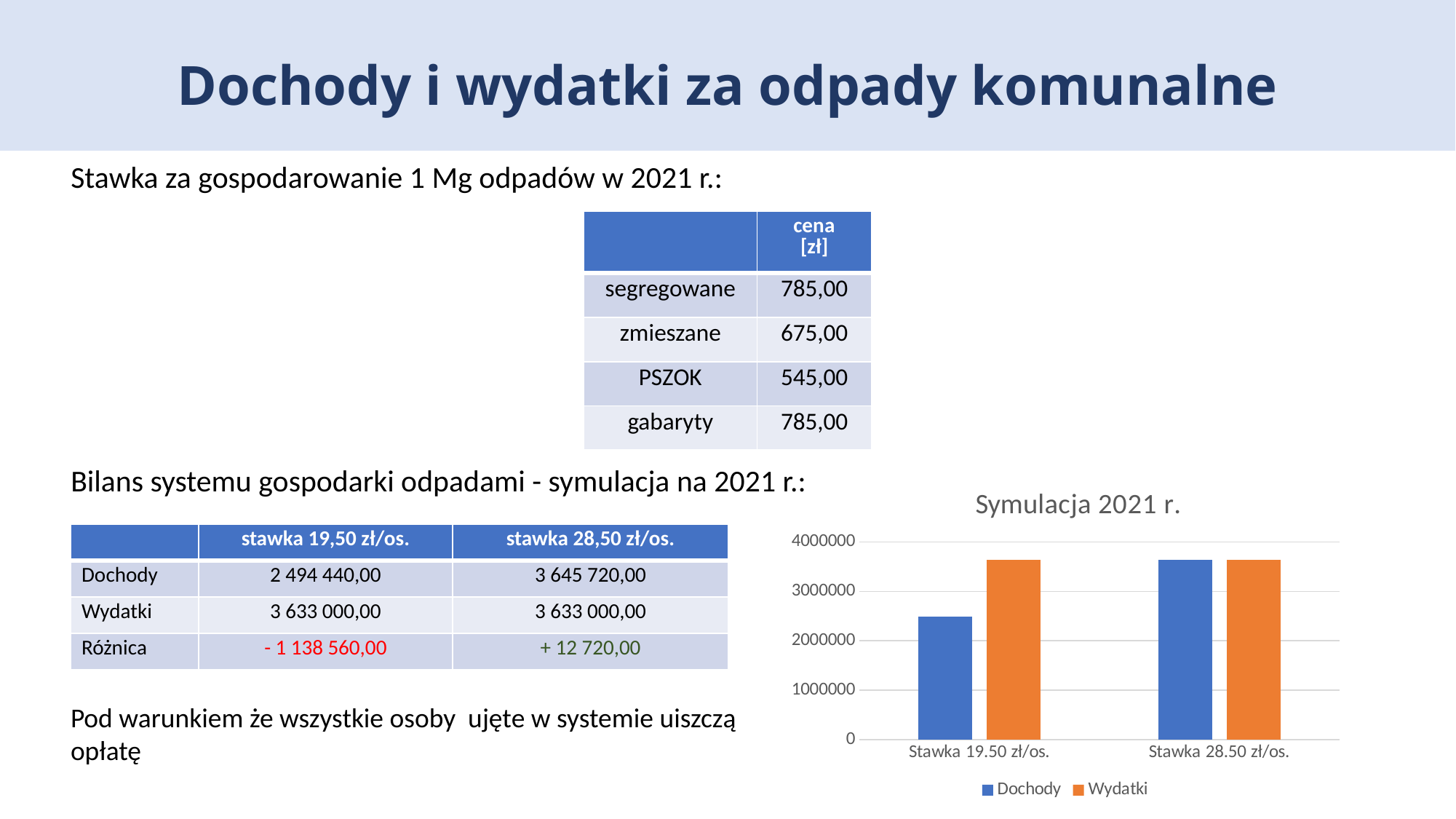
In the "Symulacja 2021 r." chart, how many series does the legend list? 2 What is the title of the bar chart on the slide? Symulacja 2021 r. In the "Symulacja 2021 r." chart, is the Dochody value for Stawka 19.50 zł/os. greater or less than 2000000? greater In the "Symulacja 2021 r." chart, is the Dochody value for Stawka 19.50 zł/os. greater or less than 3000000? less In the "Symulacja 2021 r." chart, which series is shown in orange? Wydatki In the "Symulacja 2021 r." chart, does the Dochody value rise or fall from Stawka 19.50 zł/os. to Stawka 28.50 zł/os.? rise In the "Symulacja 2021 r." chart, for Stawka 19.50 zł/os., which is larger: Dochody or Wydatki? Wydatki What kind of chart is shown under the title "Symulacja 2021 r."? bar chart In the "Symulacja 2021 r." chart, is the Wydatki value for Stawka 28.50 zł/os. greater or less than 3000000? greater In the "Symulacja 2021 r." chart, which bar is the lowest? Dochody for Stawka 19.50 zł/os. In the "Symulacja 2021 r." chart, how many categories are shown on the x axis? 2